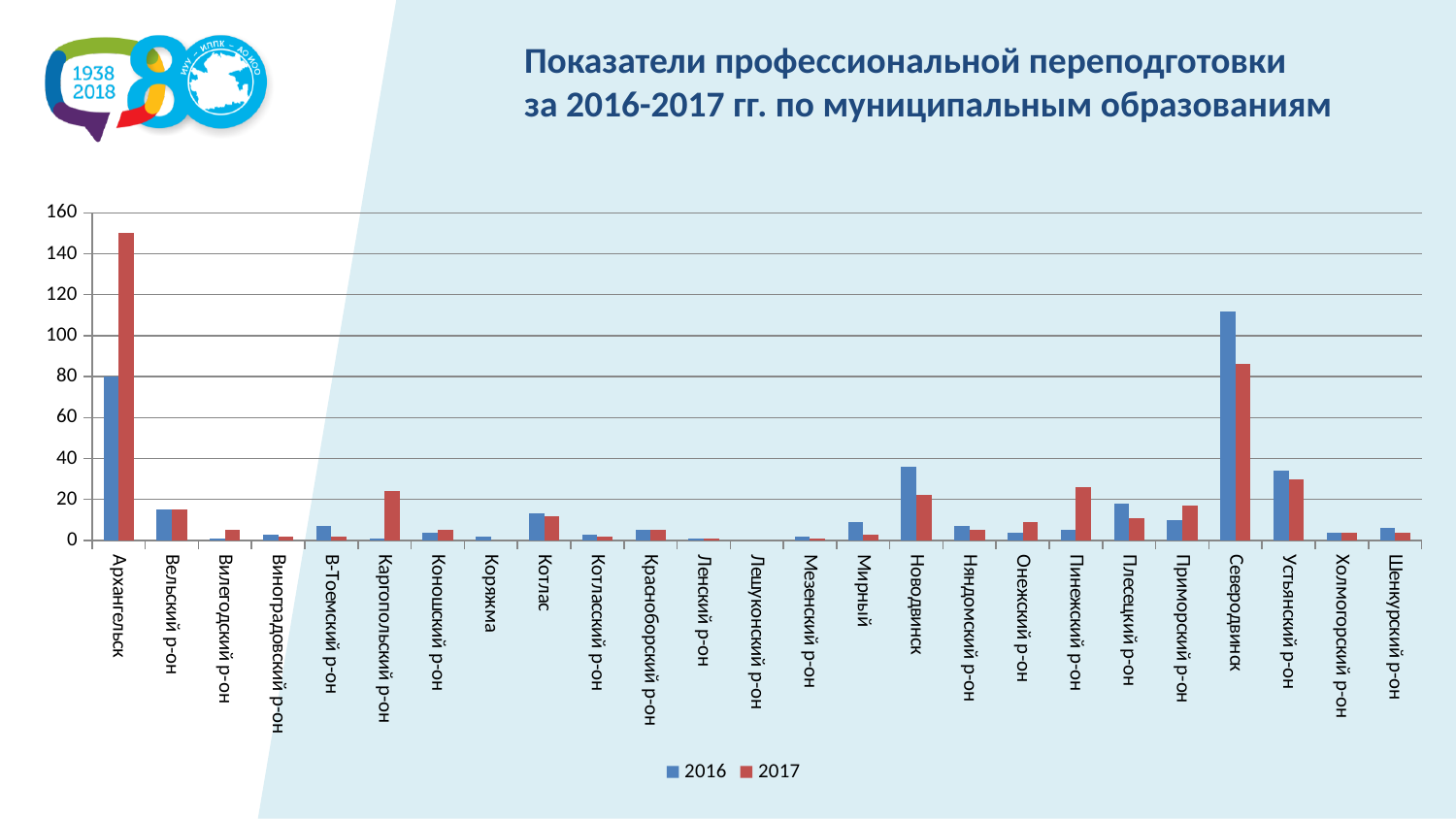
How many municipal entities (categories) are shown on the x axis? 25 For Северодвинск, which year has the larger value, 2016 or 2017? 2016 Which colour represents the 2017 series in the chart? red Is the 2016 value for Северодвинск greater or less than 100? greater How many series does the legend list? 2 Is the 2017 value for Архангельск greater or less than 140? greater For Архангельск, which year has the larger value, 2016 or 2017? 2017 What are the two series named in the legend? 2016 and 2017 Which category has the highest value for 2016? Северодвинск What kind of chart is shown on the slide? bar chart Is the 2016 value for Новодвинск greater or less than 20? greater Which category has the highest value for 2017? Архангельск